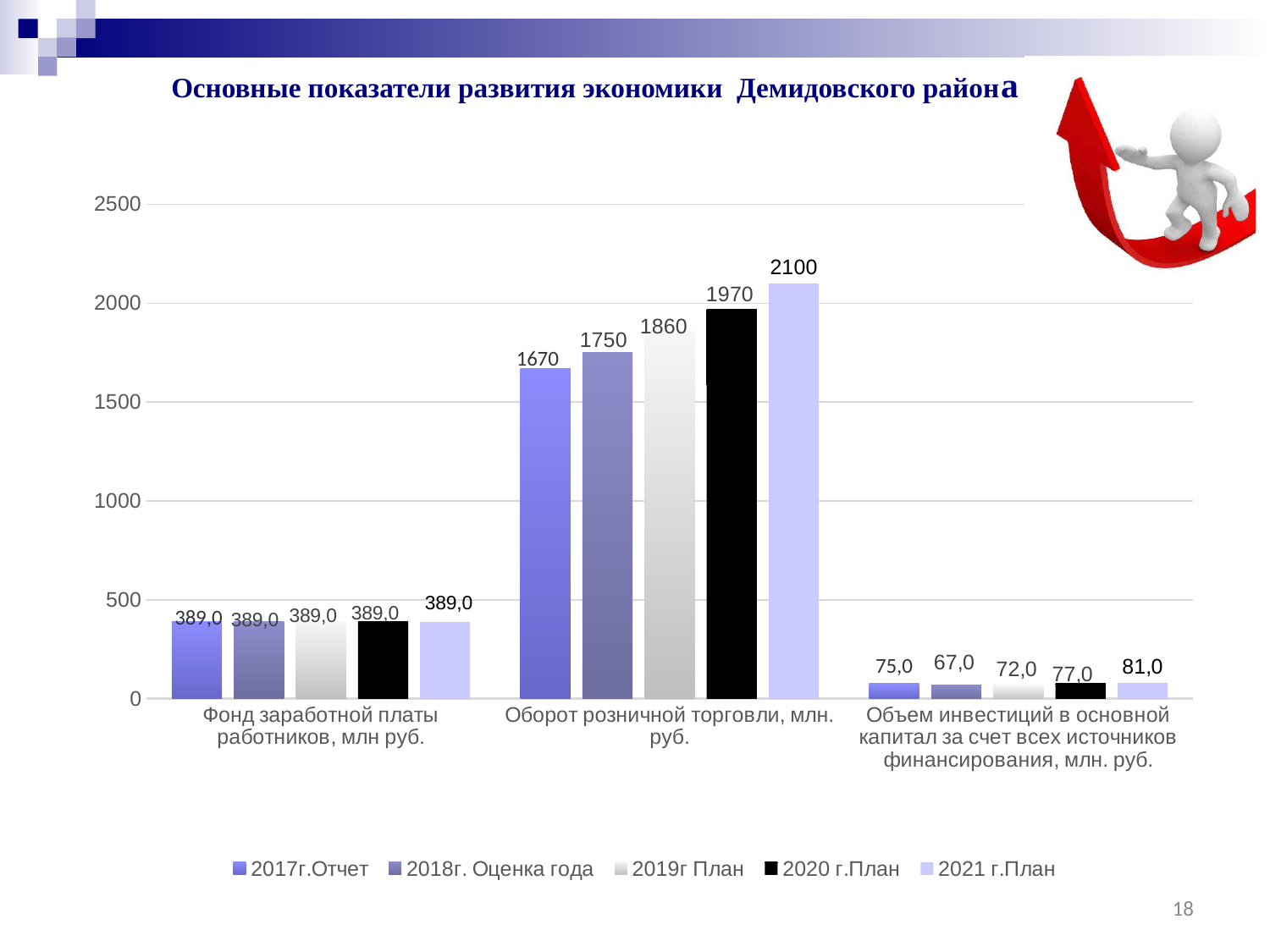
How many categories are shown on the x axis? 3 What is the value of Объем инвестиций в основной капитал for the 2018г. Оценка года series? 67,0 What is the value of Оборот розничной торговли for the 2021 г.План series? 2100 Which series has the highest value for Оборот розничной торговли? 2021 г.План What is the value of Фонд заработной платы работников for the 2017г.Отчет series? 389,0 What is the difference between the 2021 г.План and 2017г.Отчет values for Оборот розничной торговли? 430 Is the 2019г План value for Оборот розничной торговли greater or less than 2000? less Which series has the lowest value for Объем инвестиций в основной капитал? 2018г. Оценка года How many series does the legend list? 5 Do the values for Оборот розничной торговли rise or fall from 2017г.Отчет to 2021 г.План? rise Which is larger for Объем инвестиций в основной капитал: the 2019г План value or the 2020 г.План value? 2020 г.План What kind of chart is shown on the slide? bar chart